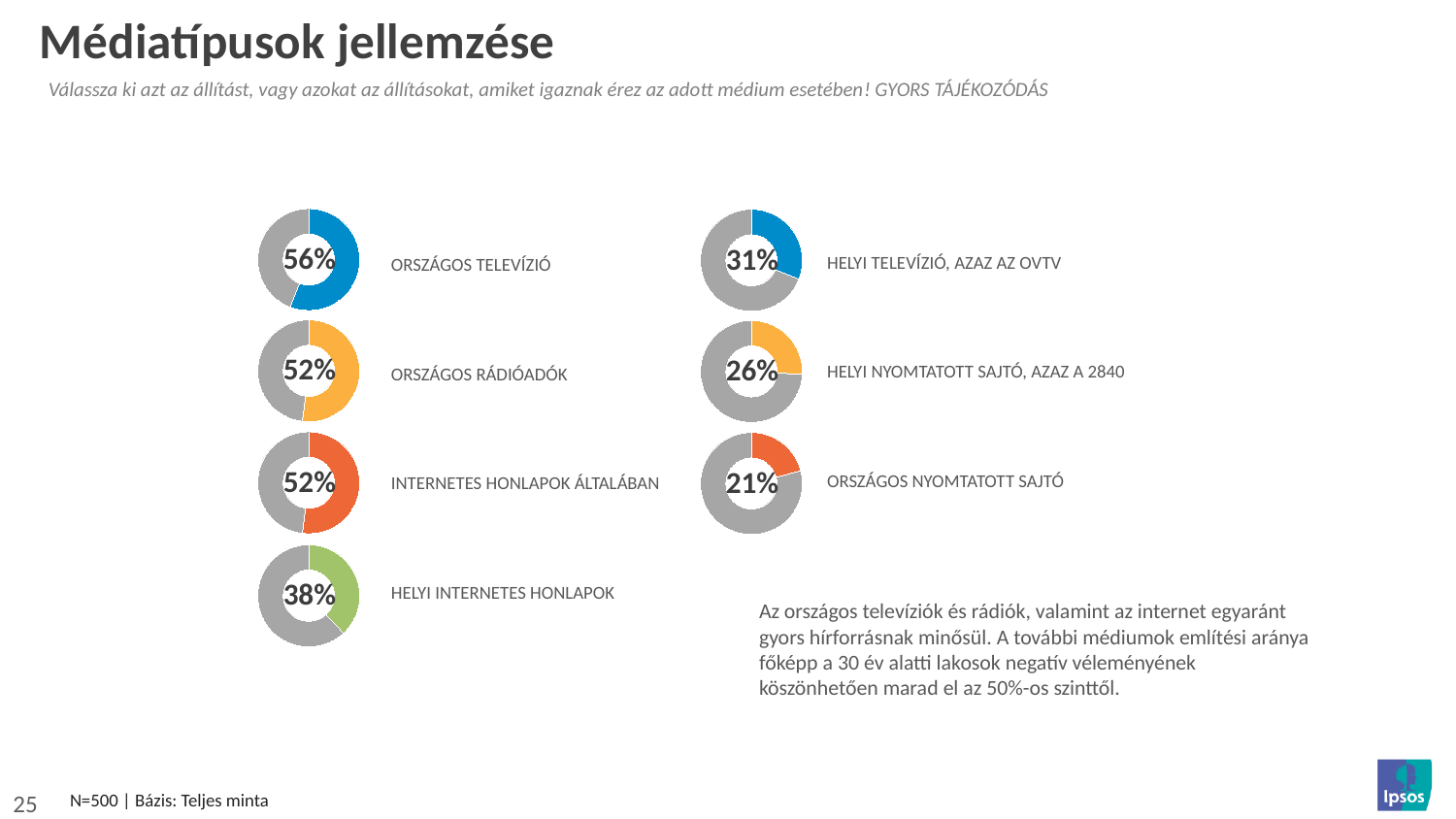
Which two media types both show a value of 52%? ORSZÁGOS RÁDIÓADÓK and INTERNETES HONLAPOK ÁLTALÁBAN How many donut charts are shown on the slide? 7 What colour is the highlighted segment in the ORSZÁGOS TELEVÍZIÓ donut chart? Blue Which has a larger percentage: HELYI INTERNETES HONLAPOK or HELYI TELEVÍZIÓ, AZAZ AZ OVTV? HELYI INTERNETES HONLAPOK What percentage is shown in the donut chart for ORSZÁGOS NYOMTATOTT SAJTÓ? 21% What percentage is shown in the donut chart for HELYI NYOMTATOTT SAJTÓ, AZAZ A 2840? 26% What is the difference in percentage points between the ORSZÁGOS TELEVÍZIÓ chart and the HELYI TELEVÍZIÓ, AZAZ AZ OVTV chart? 25 Which media type has the lowest percentage among the donut charts on the slide? ORSZÁGOS NYOMTATOTT SAJTÓ What percentage is shown in the donut chart for HELYI INTERNETES HONLAPOK? 38% What percentage is shown in the donut chart for ORSZÁGOS TELEVÍZIÓ? 56% What kind of chart is used to show the percentage for each media type? Donut (pie) chart Which media type has the highest percentage among the donut charts on the slide? ORSZÁGOS TELEVÍZIÓ